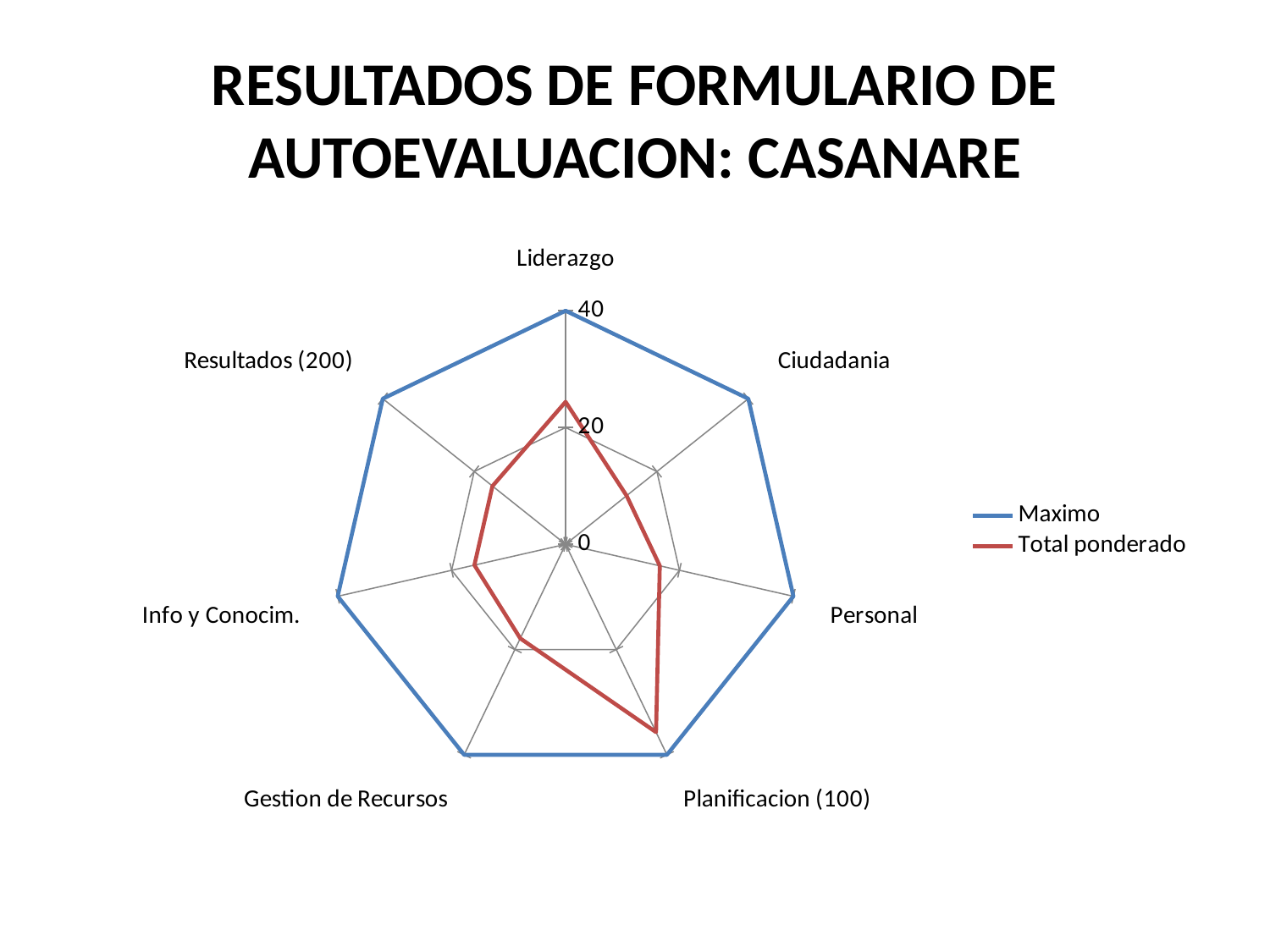
What is the Maximo value for Liderazgo? 40 What kind of chart is shown on the slide? radar chart How many series does the legend list? 2 Which has the larger Total ponderado value, Liderazgo or Personal? Liderazgo What are the two series named in the legend? Maximo and Total ponderado Which has the larger Total ponderado value, Planificacion (100) or Gestion de Recursos? Planificacion (100) Is the Total ponderado value for Gestion de Recursos greater or less than 20? less Is the Total ponderado value for Personal greater or less than 20? less For which category is the Total ponderado value highest? Planificacion (100) Is the Total ponderado value for Liderazgo greater or less than 20? greater How many categories (axes) does the radar chart have? 7 What is the Maximo value for Personal? 40